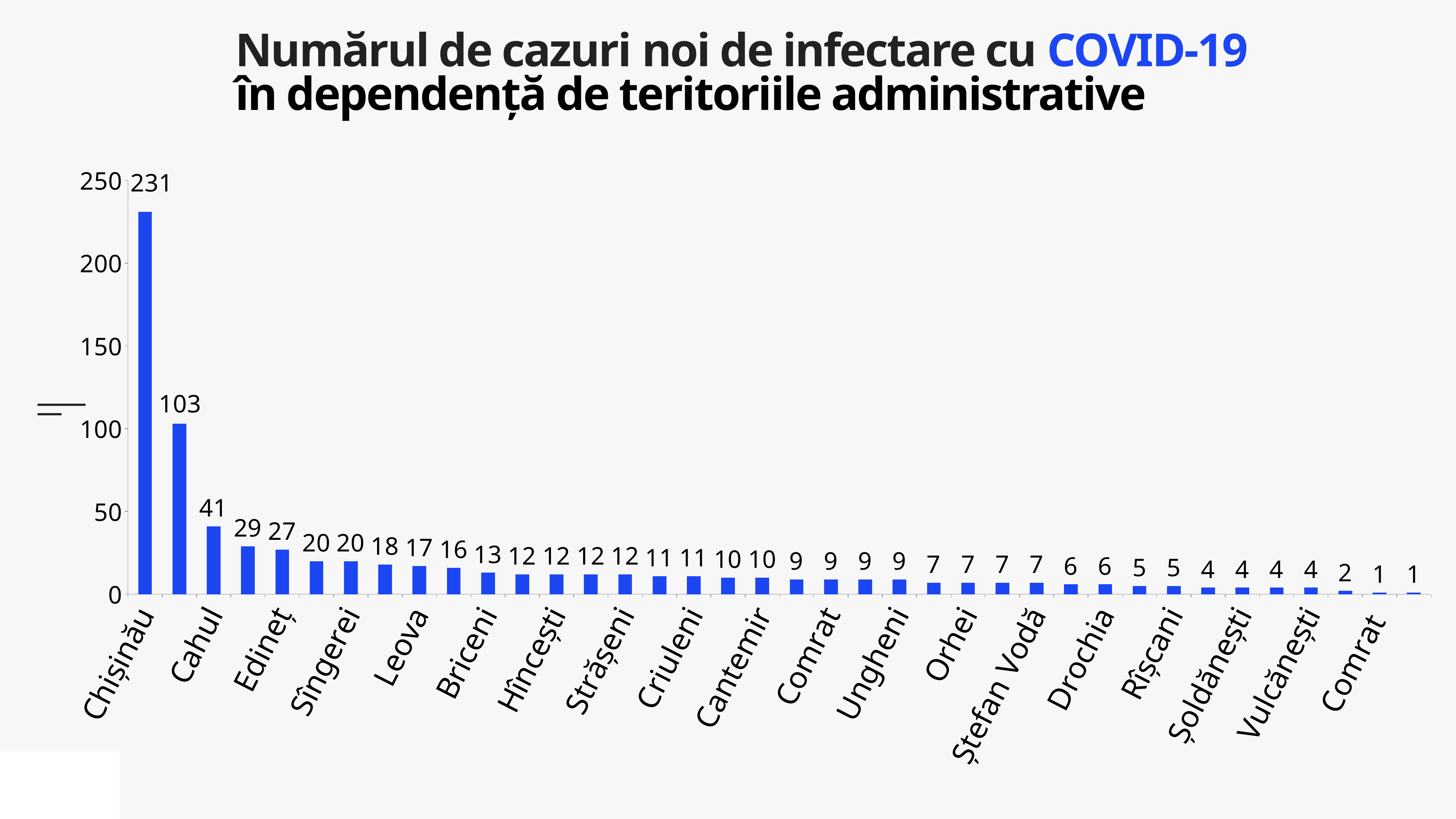
Is the value for Chișinău greater or less than 200? greater What is the title of the chart? Numărul de cazuri noi de infectare cu COVID-19 în dependență de teritoriile administrative Do the values rise or fall from left to right along the x axis? fall What is the value for Chișinău? 231 What kind of chart is shown on the slide? bar chart What is the difference between the tallest bar and the second tallest bar? 128 Which territory has the highest number of new cases? Chișinău What is the highest tick value shown on the vertical axis? 250 What is the value of the tallest bar? 231 What is the smallest value shown on the chart? 1 What is the value of the second tallest bar? 103